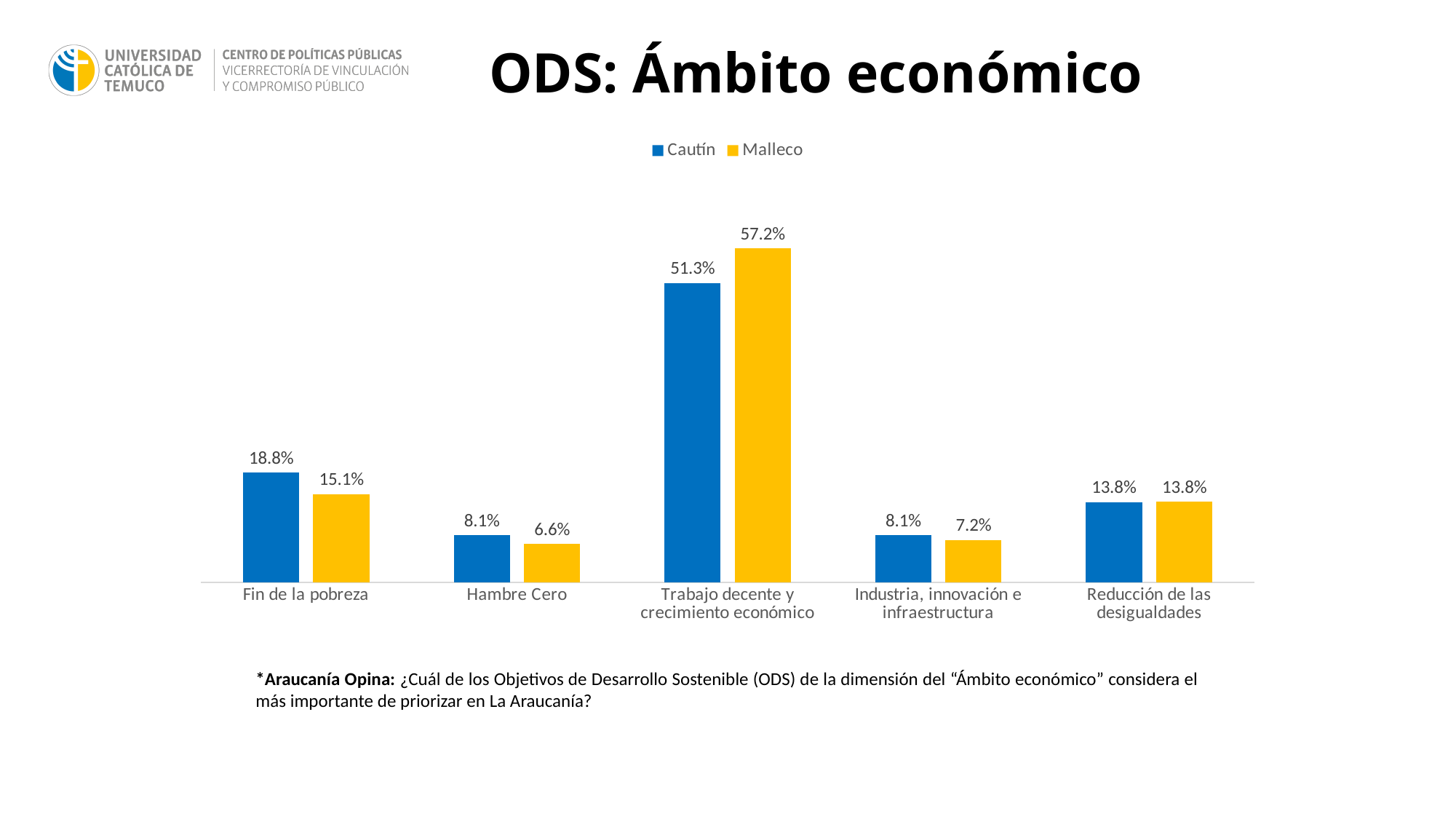
Which series is shown in yellow? Malleco What is the difference between the Cautín and Malleco values for Fin de la pobreza? 3.7% Which category has the lowest Malleco value? Hambre Cero What is the Cautín value for Fin de la pobreza? 18.8% What is the Malleco value for Trabajo decente y crecimiento económico? 57.2% How many series does the legend list? 2 What is the difference between the Malleco and Cautín values for Trabajo decente y crecimiento económico? 5.9% What is the Malleco value for Hambre Cero? 6.6% Which is larger for Industria, innovación e infraestructura: Cautín or Malleco? Cautín What kind of chart is shown on the slide? Bar chart Which category has the highest Cautín value? Trabajo decente y crecimiento económico How many categories are shown on the x axis? 5